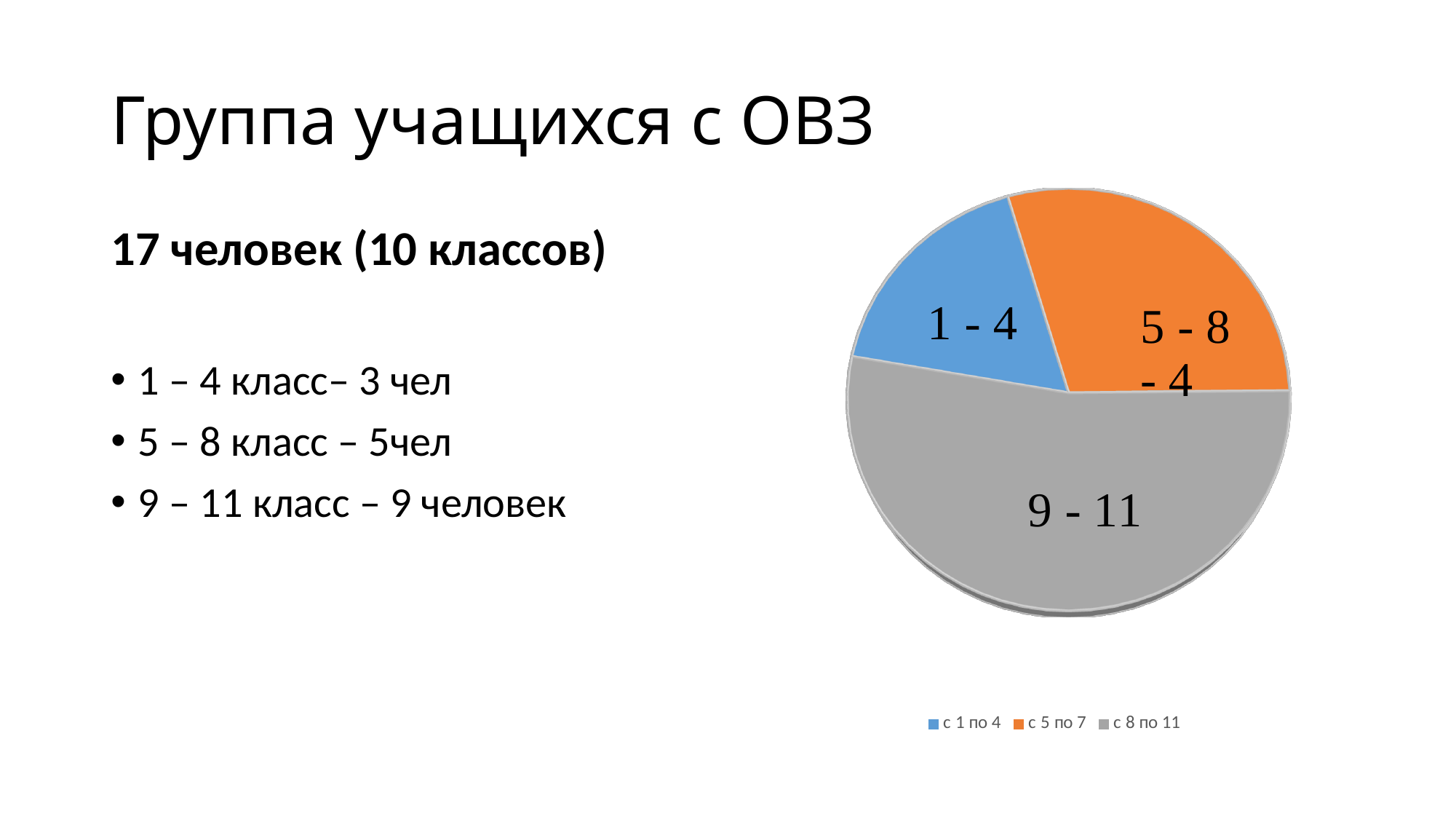
What colour is the "9 - 11" slice of the pie chart? grey What are the three entries listed in the legend of the pie chart? с 1 по 4, с 5 по 7, с 8 по 11 What kind of chart is shown on the slide? pie chart How many slices does the pie chart have? 3 Does the "9 - 11" slice take up more or less than half of the pie chart? more Which slice of the pie chart is the largest? 9 - 11 Which slice of the pie chart is the smallest? 1 - 4 Which slice is larger in the pie chart, "1 - 4" or "5 - 8"? 5 - 8 Which slice is larger in the pie chart, "1 - 4" or "9 - 11"? 9 - 11 How many entries does the legend of the pie chart list? 3